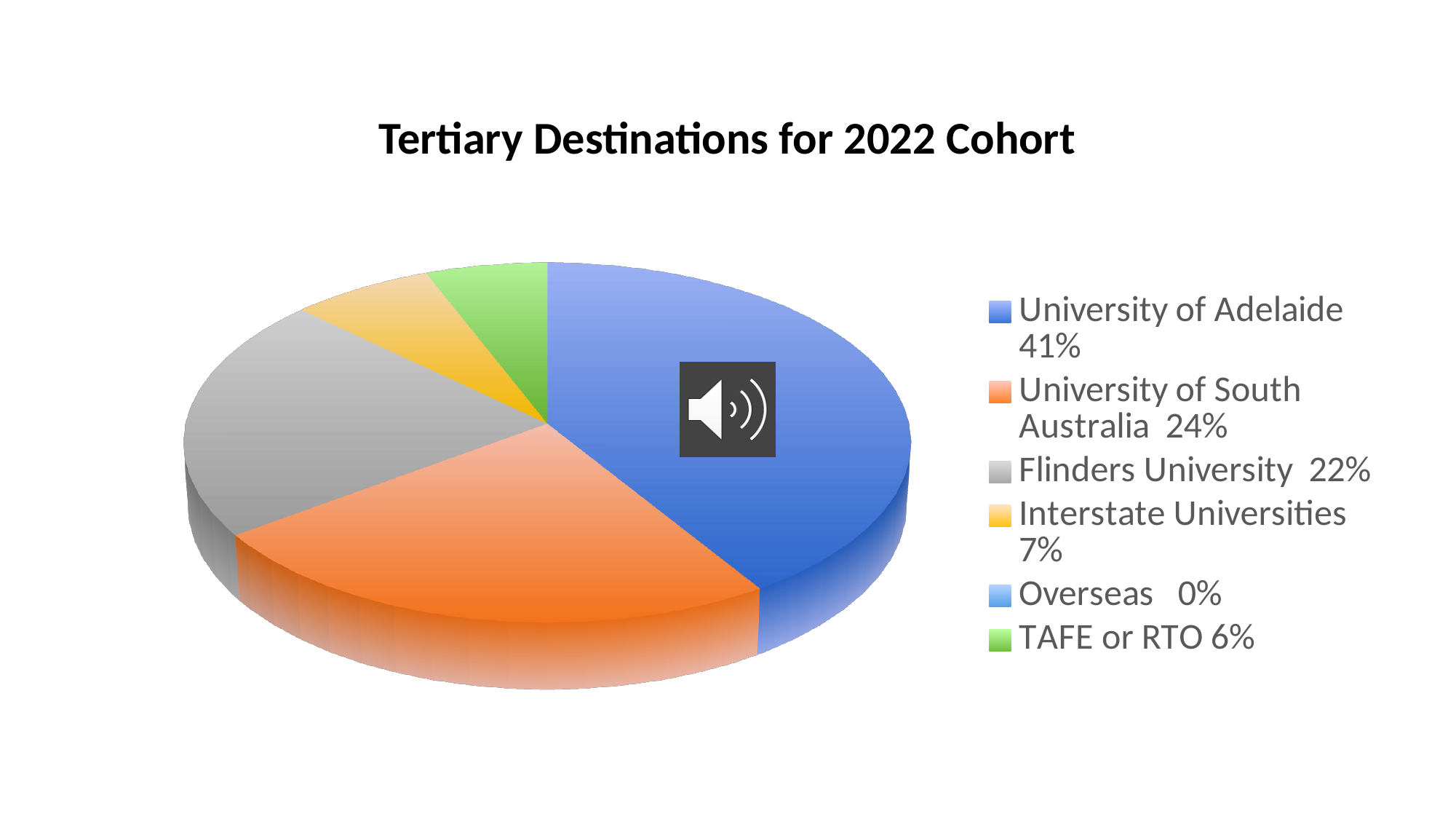
What percentage of the 2022 cohort went to TAFE or RTO? 6% Which has a larger share, University of South Australia or Flinders University? University of South Australia What is the title of the chart? Tertiary Destinations for 2022 Cohort Which destination has the smallest share of the 2022 cohort? Overseas What colour is the slice for Flinders University? grey What percentage of the 2022 cohort went to Flinders University? 22% What percentage of the 2022 cohort went to the University of Adelaide? 41% What percentage of the 2022 cohort went to Interstate Universities? 7% What is the difference in percentage points between University of Adelaide and University of South Australia? 17 What kind of chart is shown on the slide? pie chart Which destination has the largest share of the 2022 cohort? University of Adelaide How many destination categories does the legend list? 6